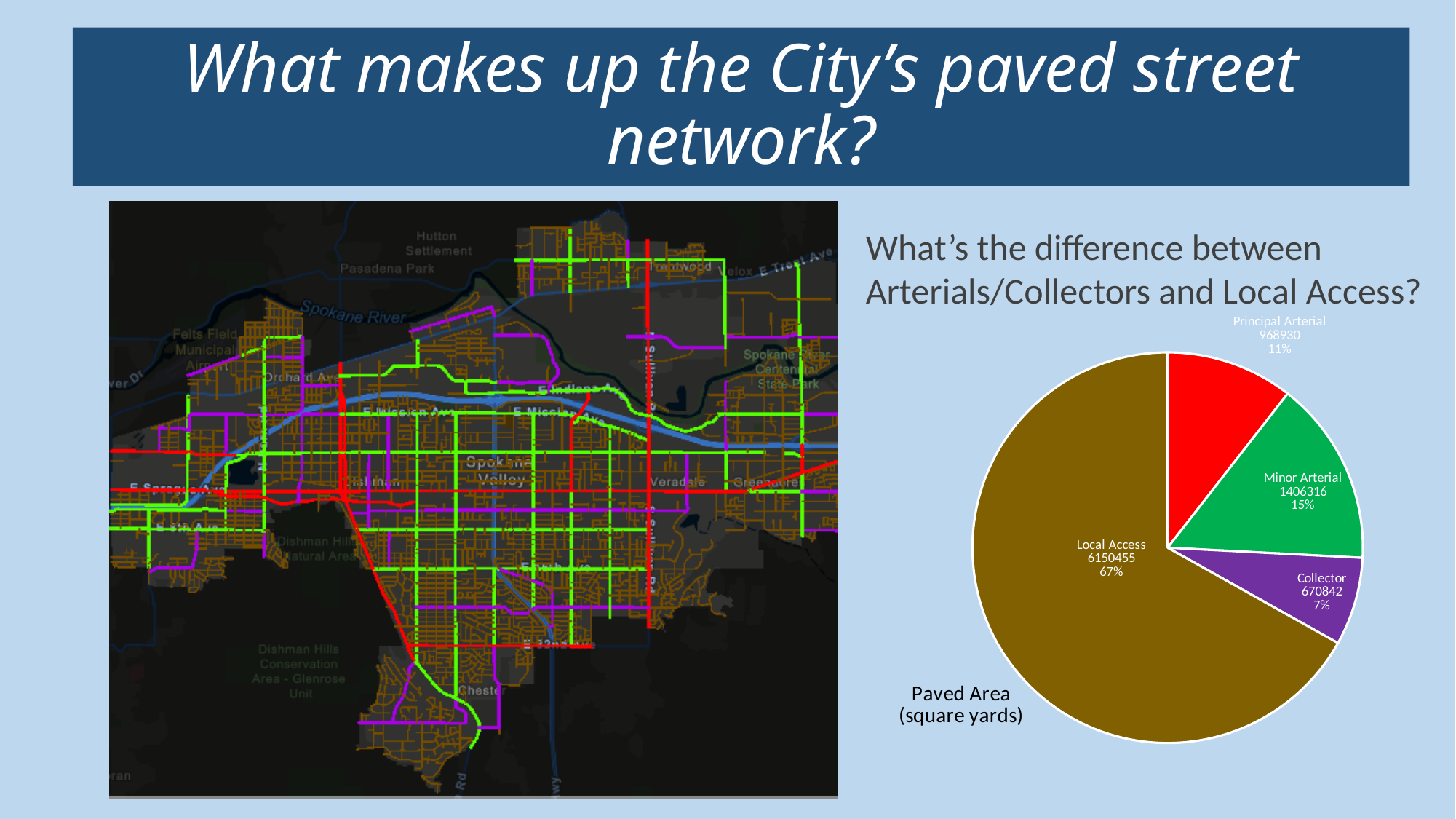
What is the paved area value for Collector? 670842 Which is larger, the paved area for Principal Arterial or for Collector? Principal Arterial What is the paved area value for Principal Arterial? 968930 What type of chart is shown on the slide? pie chart What is the paved area value for Local Access? 6150455 Which category has the largest share of the pie chart? Local Access What percentage share of the pie does Local Access have? 67% How many slices does the pie chart have? 4 What is the paved area value for Minor Arterial? 1406316 What is the difference between the paved area for Minor Arterial and Principal Arterial? 437386 What percentage share of the pie does Minor Arterial have? 15% Which category has the smallest share of the pie chart? Collector